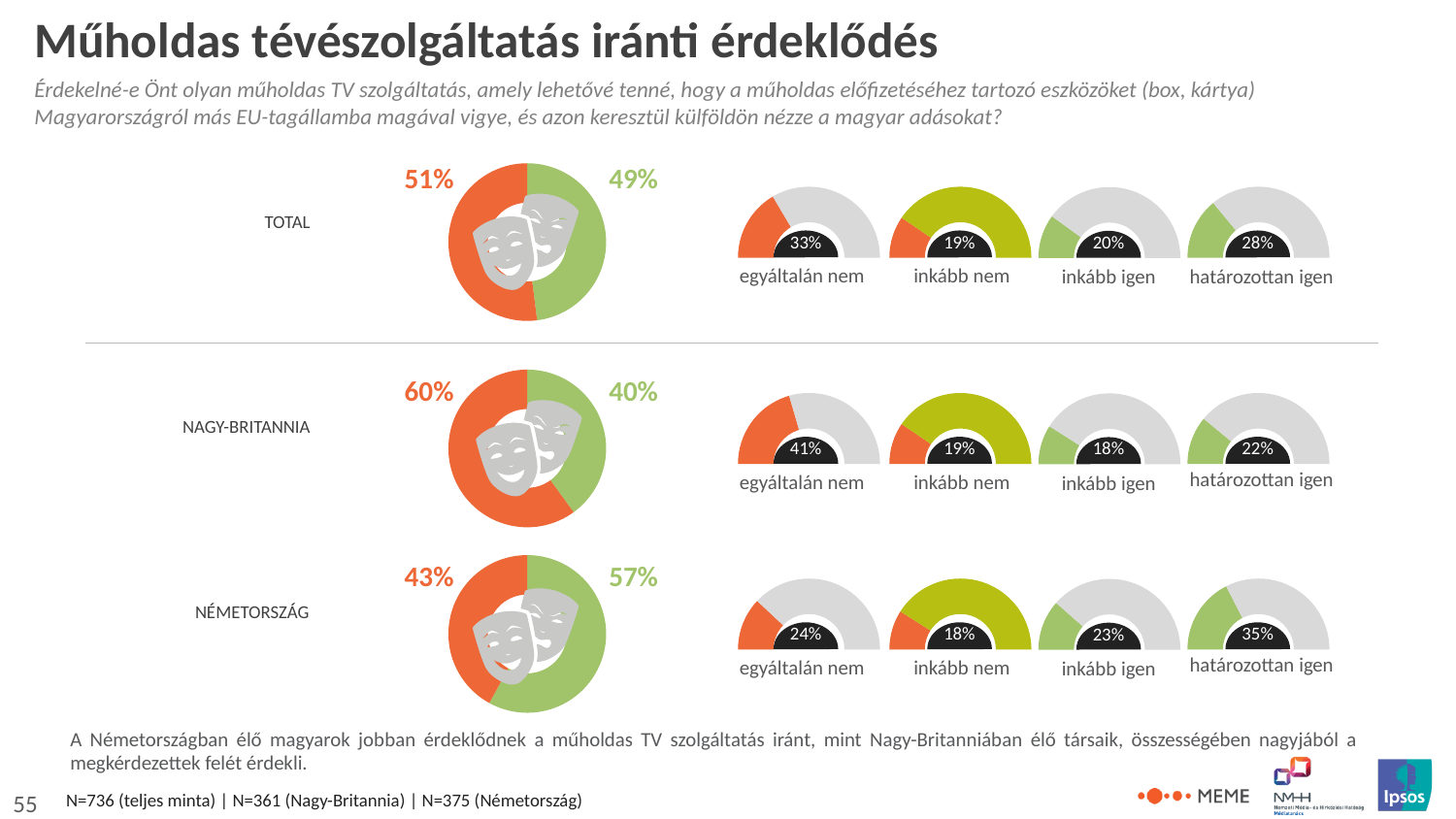
Which is larger: the 'határozottan igen' value for TOTAL or for NAGY-BRITANNIA? TOTAL In the NAGY-BRITANNIA row, which of the four gauge categories has the highest value? egyáltalán nem What is the difference between the 'egyáltalán nem' values for NAGY-BRITANNIA and NÉMETORSZÁG? 17% What type of chart is used to show the 51% / 49% split in the TOTAL row? Donut chart In the TOTAL row, what percentage does the orange segment of the donut chart show? 51% In the NÉMETORSZÁG row, which of the four gauge categories has the lowest value? inkább nem In the TOTAL row, what is the value shown for 'egyáltalán nem'? 33% In the NÉMETORSZÁG row, what is the total of the 'inkább igen' and 'határozottan igen' values? 58% In the NAGY-BRITANNIA row, what percentage does the green segment of the donut chart show? 40% How many gauge charts are shown in each row of the slide? 4 In the NÉMETORSZÁG row, what is the value shown for 'határozottan igen'? 35% What is the title of the slide? Műholdas tévészolgáltatás iránti érdeklődés